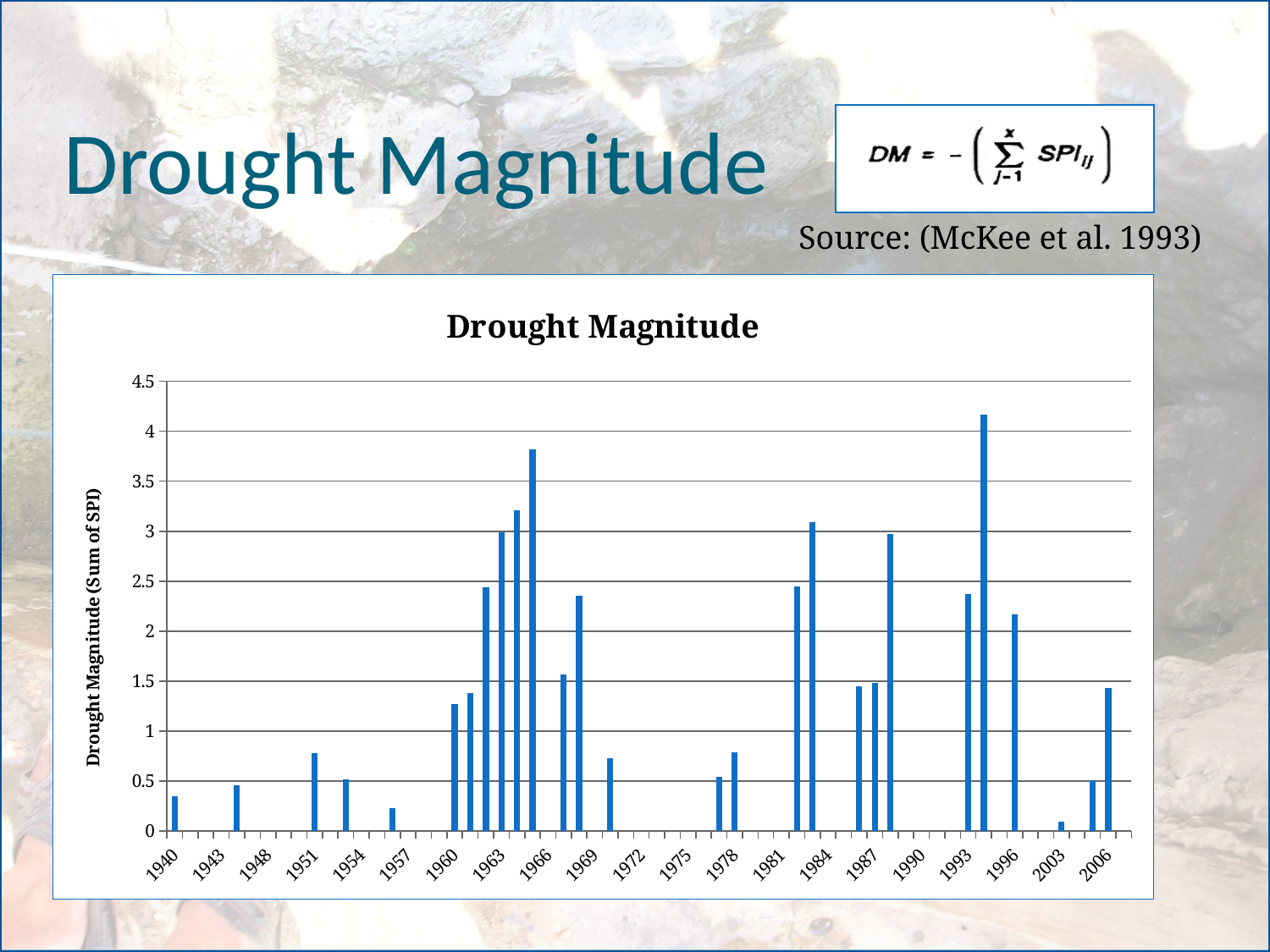
What is the title of the chart? Drought Magnitude Is the value for 2003 greater or less than 0.5? less What type of chart is shown on the slide? bar chart Is the value for 1957 greater or less than 0.5? less Is the tallest bar in the chart greater or less than 4? greater What is the label on the vertical axis of the chart? Drought Magnitude (Sum of SPI)